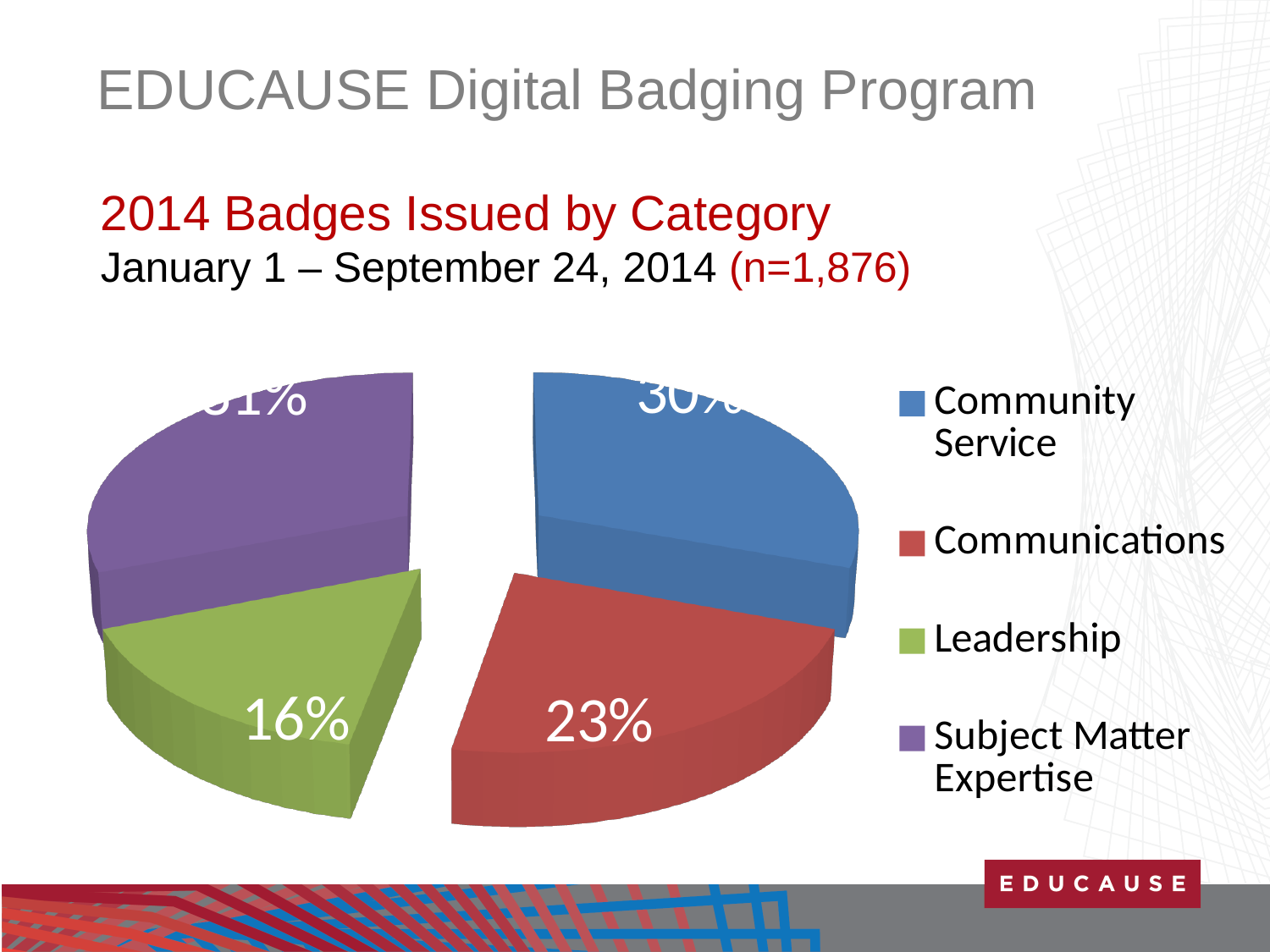
What is the title of the chart? 2014 Badges Issued by Category Which category has a larger share of badges: Community Service or Leadership? Community Service What kind of chart is shown on the slide? pie chart What percentage of badges were issued in the Communications category? 23% What colour represents the Communications category in the pie chart? red Which category has a larger share of badges: Communications or Leadership? Communications How many categories are shown in the pie chart? 4 By how many percentage points does the Communications share exceed the Leadership share? 7 percentage points Which category has the smallest share of badges issued? Leadership What share of the pie does the Leadership slice represent? 16% What percentage of badges were issued in the Leadership category? 16% How many entries does the legend list? 4